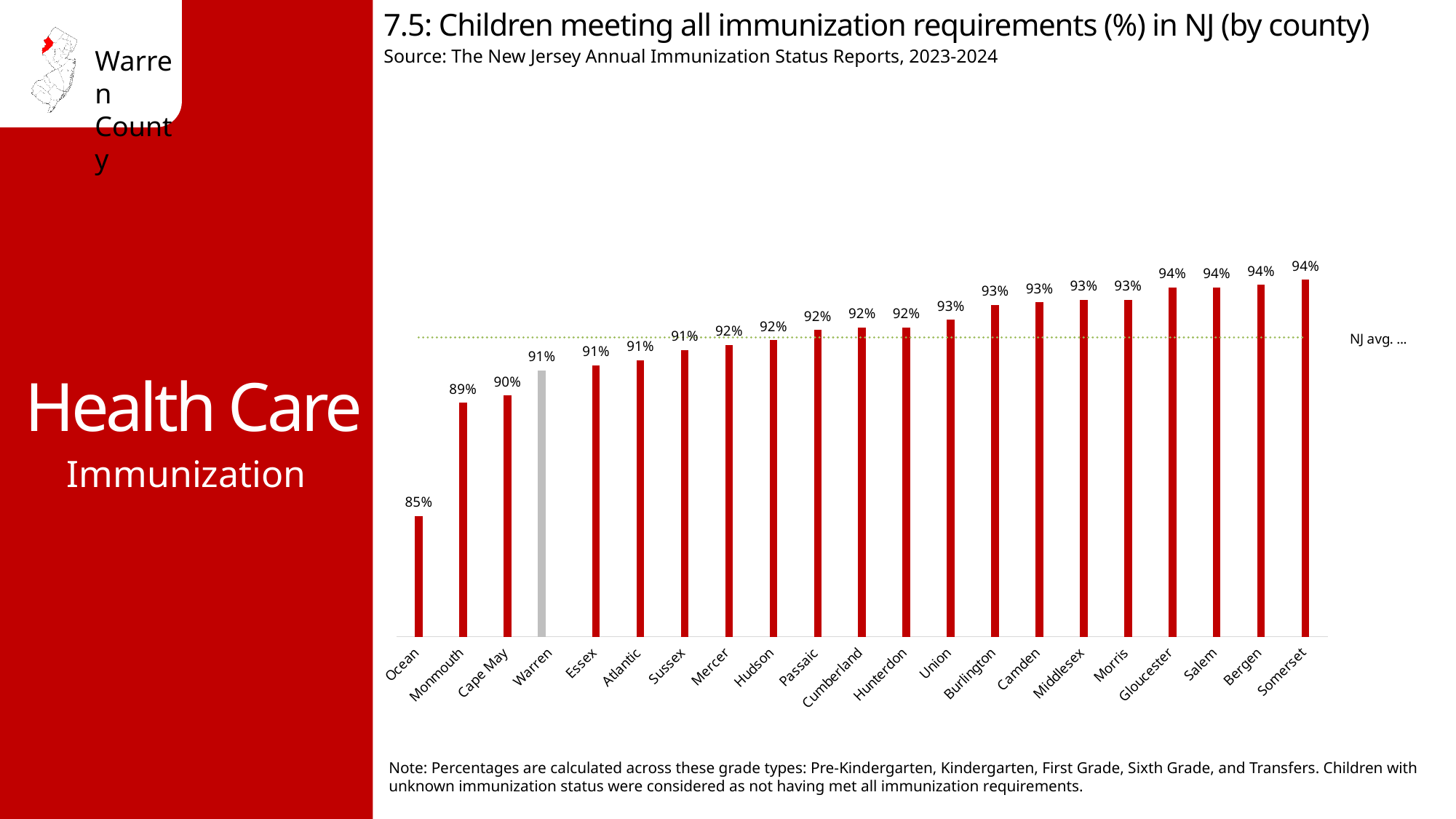
What is the difference between the values for Cape May and Monmouth? 1 percentage point What percentage of children in Ocean County met all immunization requirements? 85% What kind of chart is shown on the slide? Bar chart What is the value for Somerset County? 94% What percentage is shown for Monmouth County? 89% Do the values generally rise or fall from left to right across the counties? Rise How many counties are shown in the chart? 21 What is the difference between the values for Somerset and Ocean? 9 percentage points Which has a higher value, Ocean or Monmouth? Monmouth What is the value shown for Warren County? 91% Which county has the lowest percentage of children meeting all immunization requirements? Ocean Which has a higher value, Warren or Union? Union